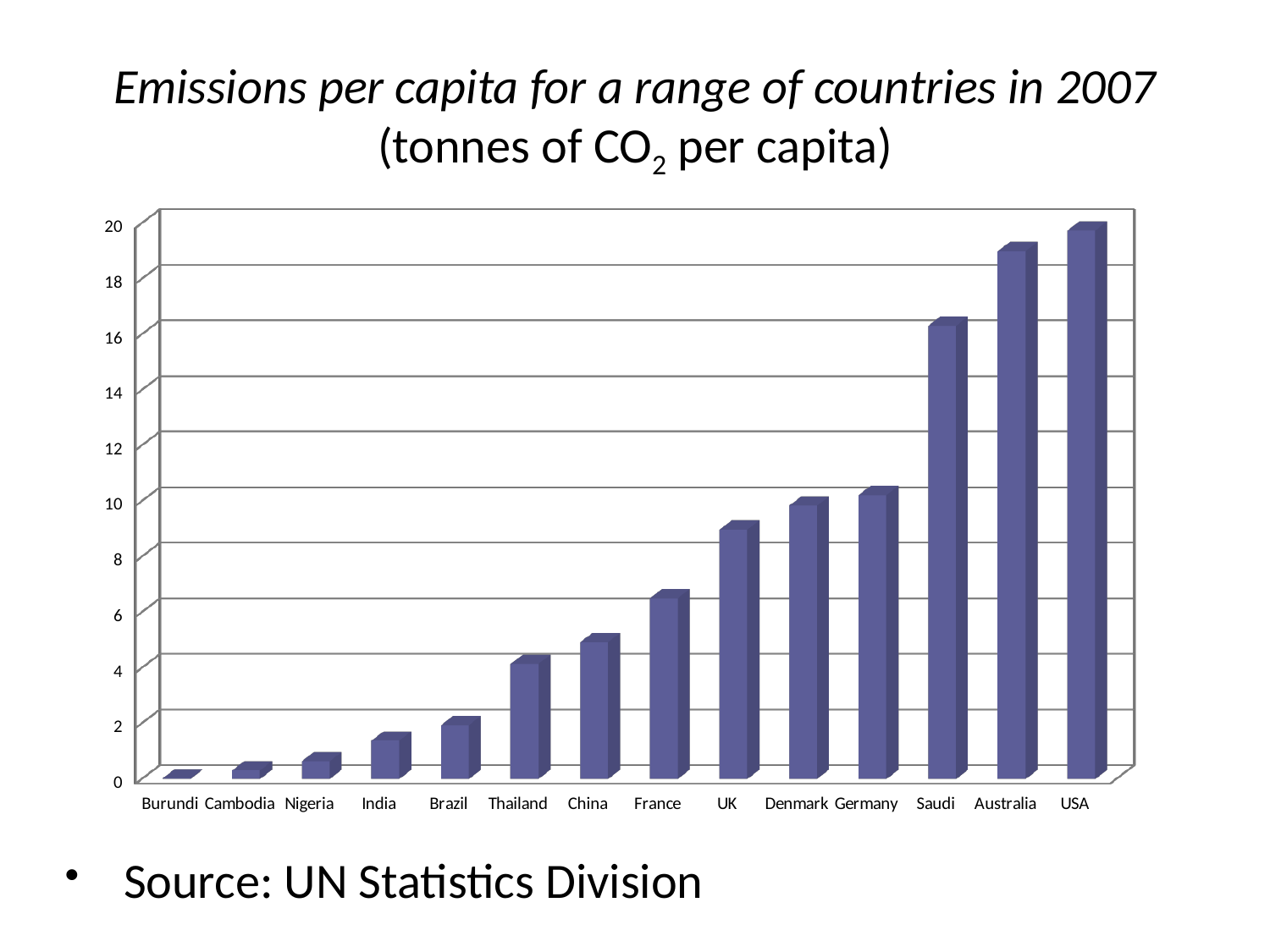
Do the values rise or fall moving from left to right along the x axis? rise Is the value for USA greater or less than 18? greater Is the value for India greater or less than 2? less How many countries are shown on the chart? 14 Which country has the lowest emissions per capita on the chart? Burundi Is the value for UK greater or less than 10? less Which has the larger value, Saudi or Germany? Saudi What kind of chart is shown on the slide? bar chart Which country has the highest emissions per capita on the chart? USA What unit is given in the chart title for the emissions values? tonnes of CO2 per capita